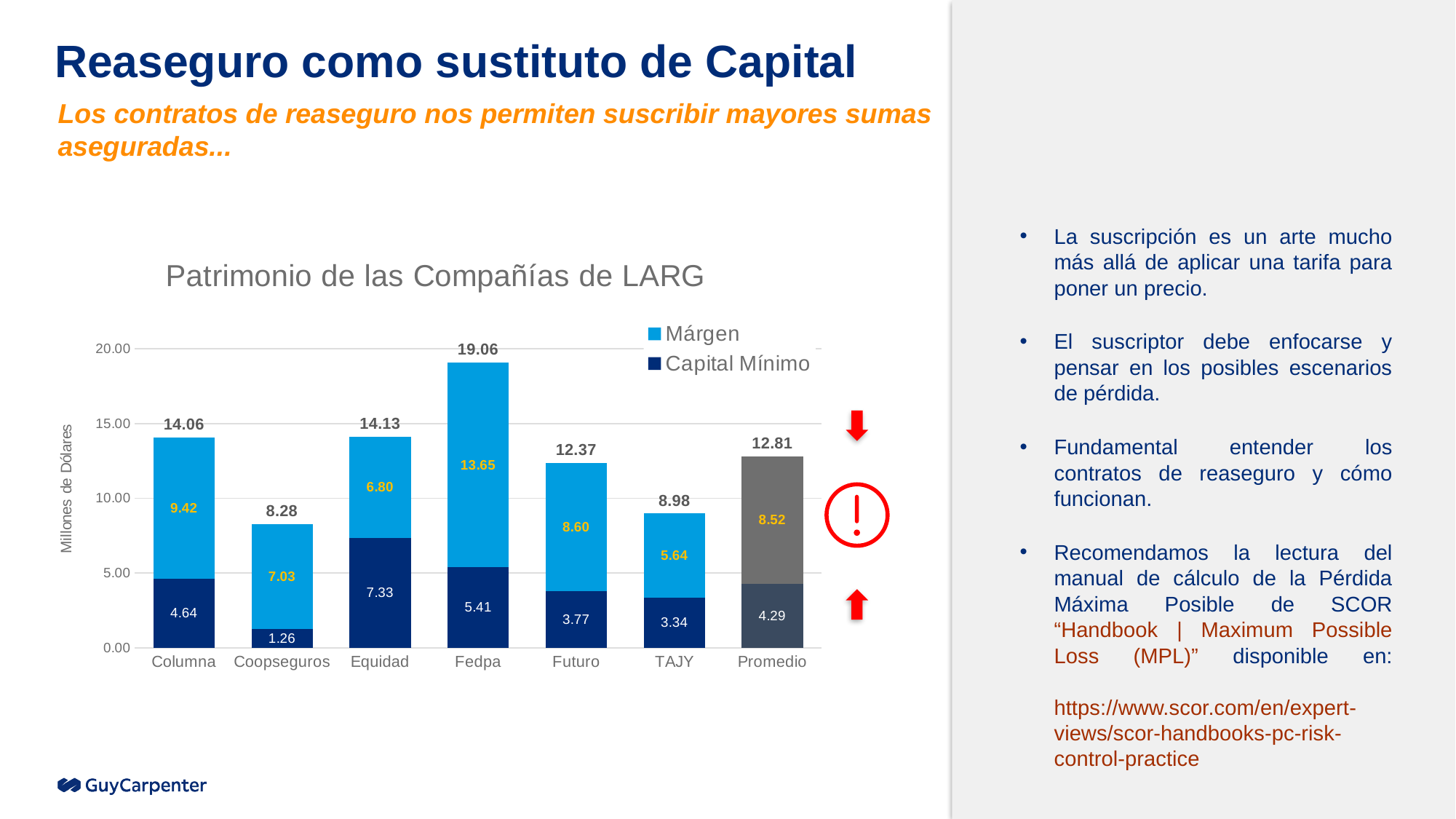
What is the Capital Mínimo value for Equidad? 7.33 Which category has the lowest Capital Mínimo value? Coopseguros What is the title of the chart? Patrimonio de las Compañías de LARG What is the label of the y axis? Millones de Dólares What kind of chart is shown on the slide? Stacked bar chart Which is larger, the Márgen value for Columna or the Márgen value for Promedio? Columna How many series does the chart legend list? 2 Which category has the highest total bar? Fedpa What is the Márgen value for Fedpa? 13.65 What is the total value of the stacked bar for Futuro? 12.37 How many companies/categories are shown on the x axis of the chart? 7 What is the difference between the total for Columna and the total for TAJY? 5.08